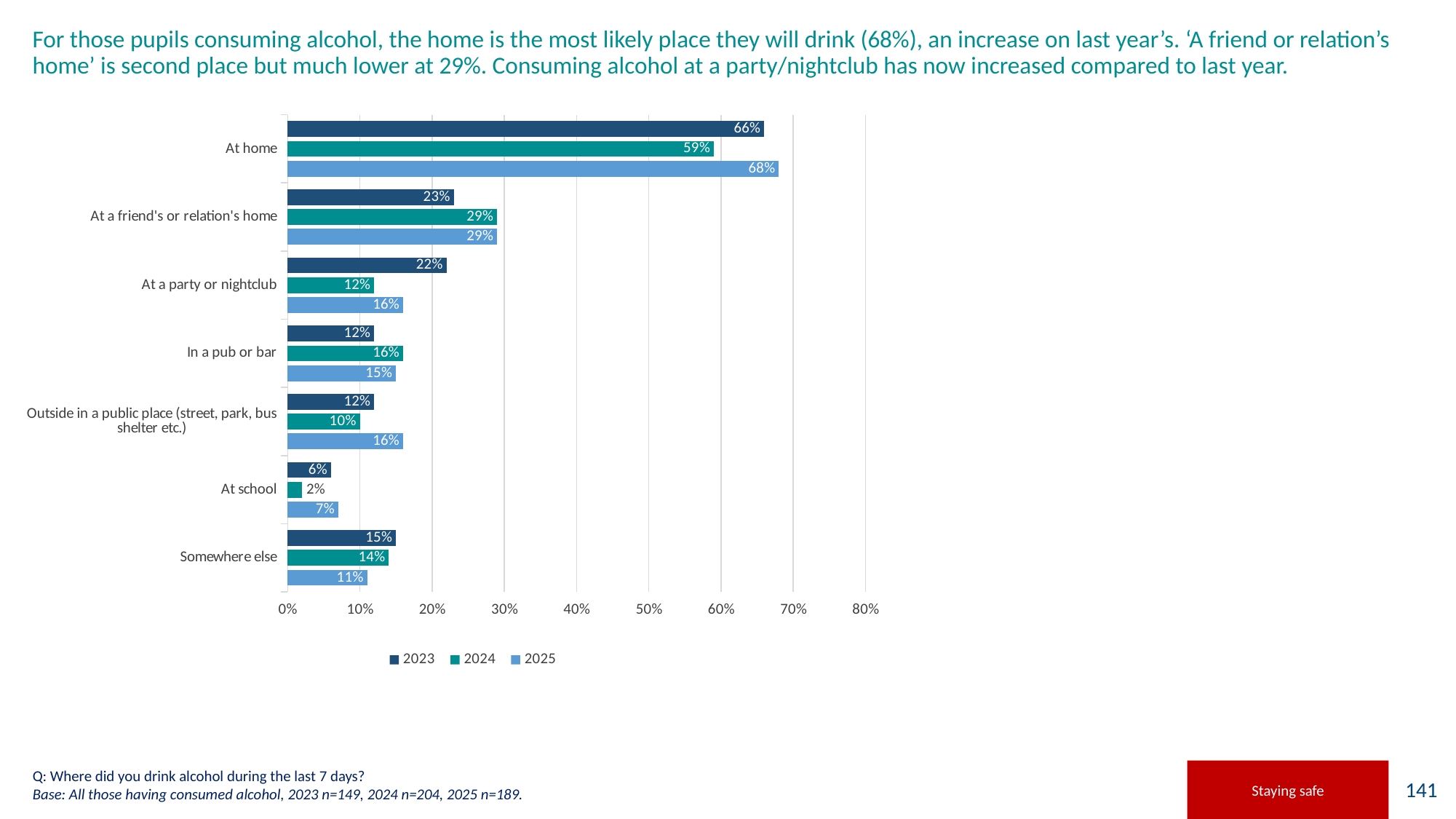
What is the 2024 value for 'At school'? 2% Which is larger for 'Somewhere else': the 2023 value or the 2025 value? 2023 What is the 2024 value for 'At a party or nightclub'? 12% Which category has the highest 2025 value? At home What kind of chart is shown on the slide? Bar chart Which category has the lowest 2023 value? At school What is the 2025 value for 'At home'? 68% What is the difference between the 2025 and 2024 values for 'At home'? 9% How many categories are shown on the chart? 7 How many series does the legend list? 3 What is the 2023 value for 'In a pub or bar'? 12% What are the series names listed in the legend? 2023, 2024, 2025